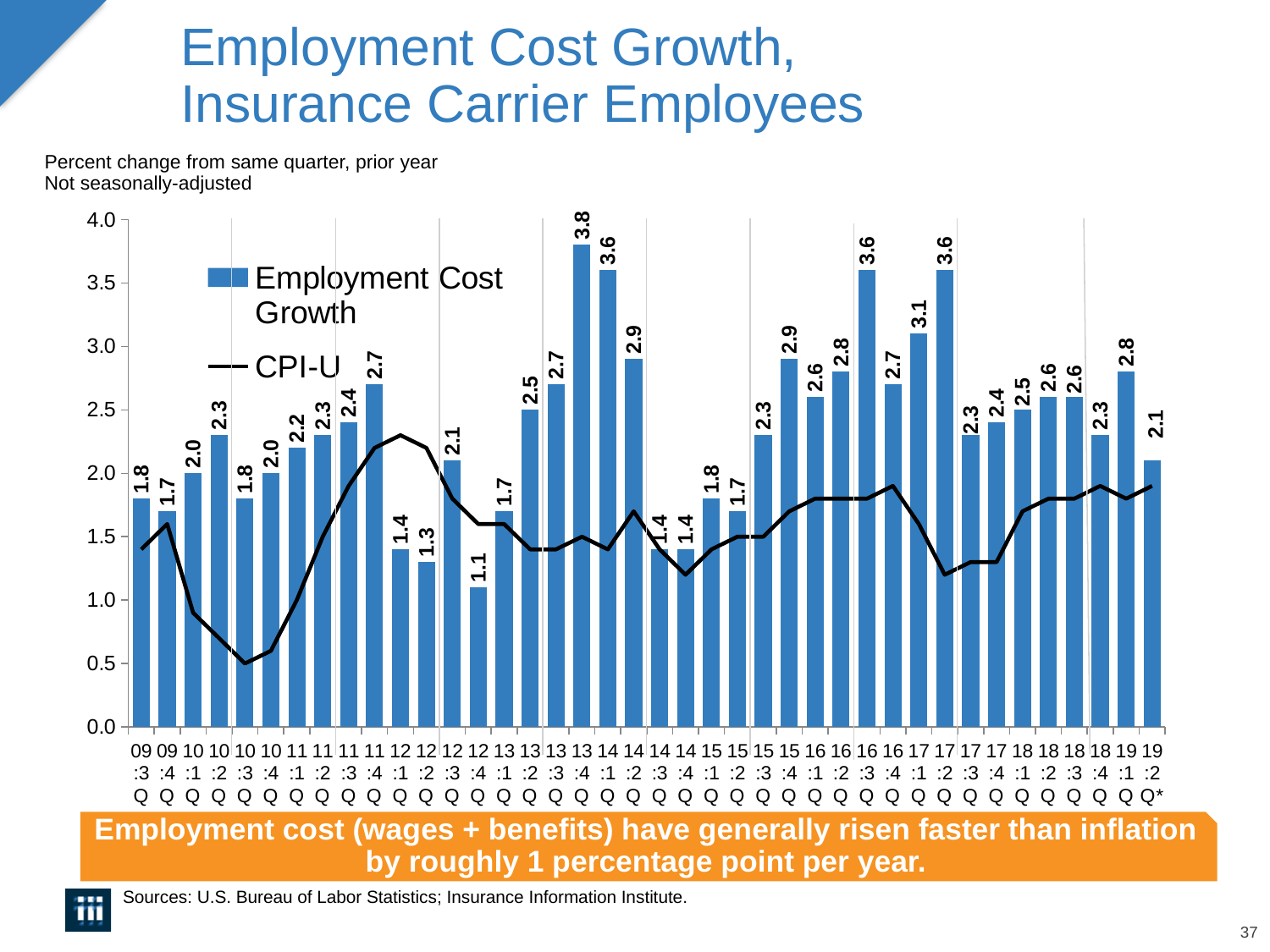
Is the CPI-U value for 10:3Q greater or less than 1.0? less Which quarter has the lowest Employment Cost Growth bar? 12:4Q What is the Employment Cost Growth value for 12:4Q? 1.1 How many quarters are shown on the x axis? 40 What is the Employment Cost Growth value for the last quarter shown, 19:2Q*? 2.1 Which has the larger Employment Cost Growth value, 16:3Q or 17:1Q? 16:3Q Which quarter has the highest Employment Cost Growth bar? 13:4Q What is the Employment Cost Growth value for 13:4Q? 3.8 What is the difference between the Employment Cost Growth values for 19:1Q and 19:2Q*? 0.7 What kind of chart is shown on the slide? Bar chart with a line How many series does the legend list? 2 What is the difference between the Employment Cost Growth values for 13:4Q and 14:1Q? 0.2